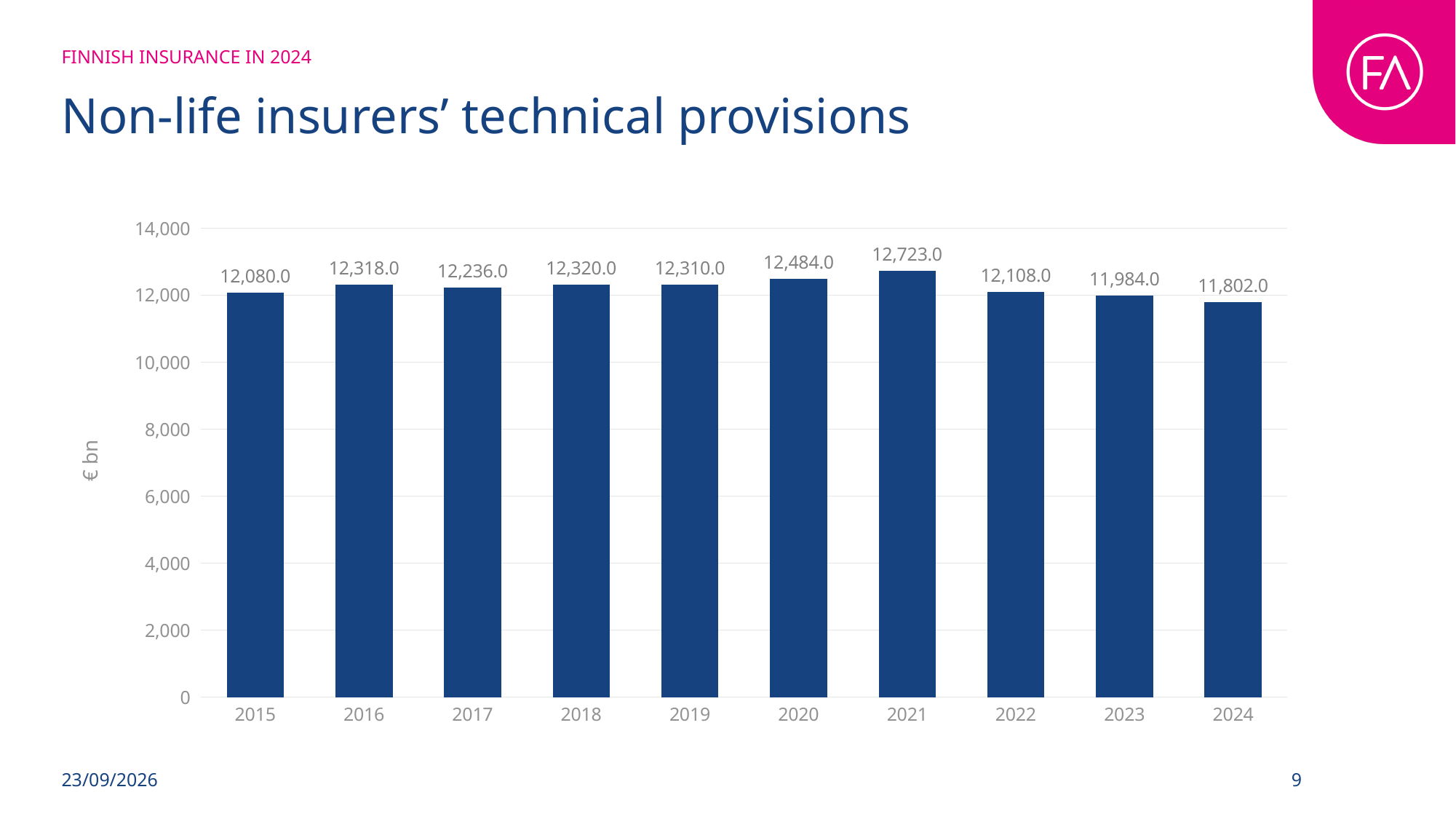
Which year has the lowest value? 2024 How many years are shown on the x axis? 10 What is the value for 2024? 11,802.0 What is the difference between the values for 2020 and 2019? 174.0 What is the value for 2015? 12,080.0 Which year has the highest value? 2021 Which is larger, the value for 2016 or the value for 2017? 2016 Is the value for 2023 greater or less than 12,000? less What is the label on the vertical axis? € bn What is the value for 2021? 12,723.0 What is the difference between the values for 2021 and 2024? 921.0 What kind of chart is shown on the slide? bar chart